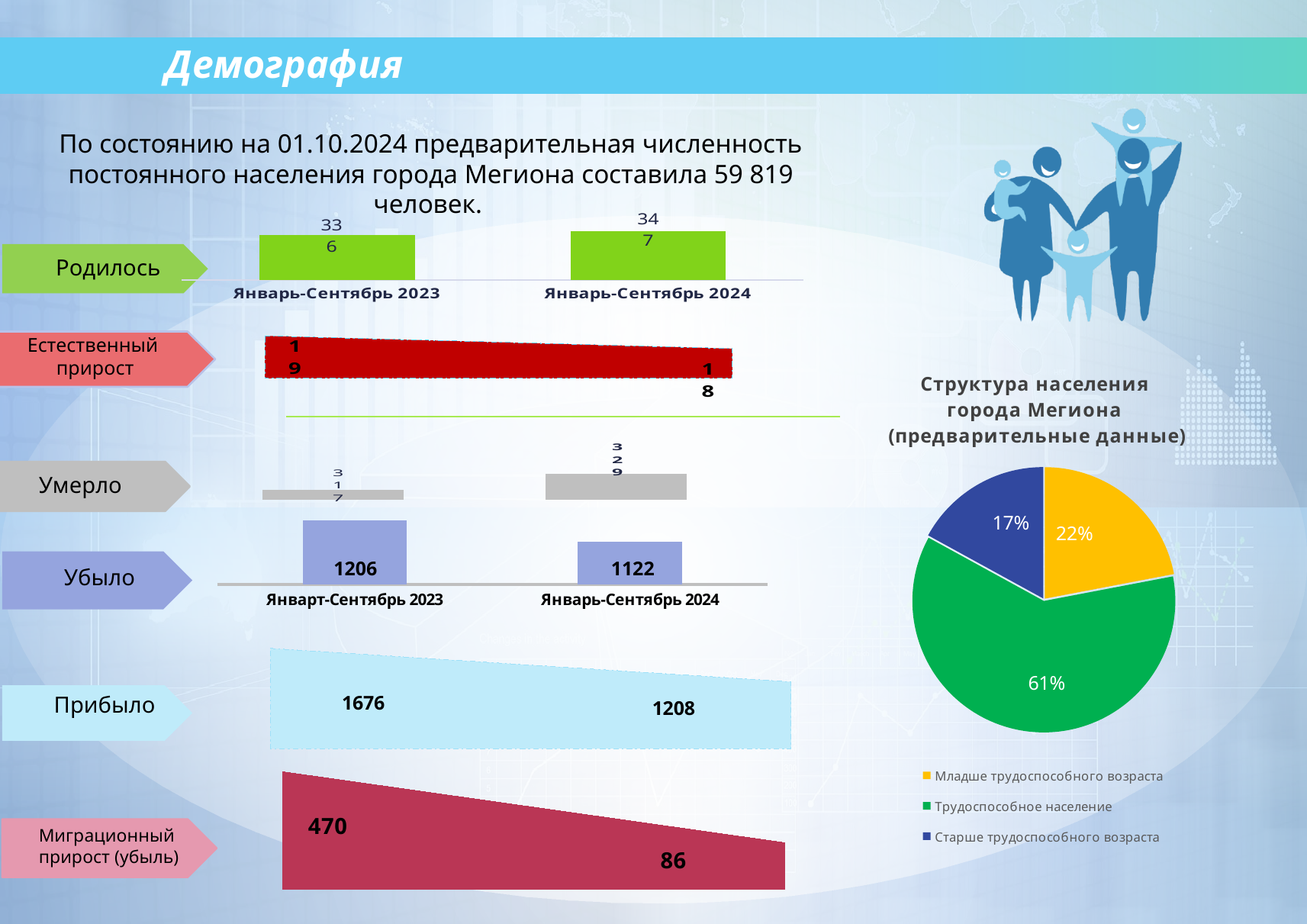
In the 'Убыло' bar chart, what is the value for Январт-Сентябрь 2023? 1206 In the 'Прибыло' chart, what is the first value shown (Январь-Сентябрь 2023)? 1676 In the 'Миграционный прирост (убыль)' chart, what is the value for 2024? 86 How many slices does the pie chart 'Структура населения города Мегиона' have? 3 In the pie chart 'Структура населения города Мегиона', what share is Трудоспособное население? 61% In the 'Убыло' bar chart, what is the difference between the 2023 and 2024 values? 84 In the 'Миграционный прирост (убыль)' chart, what is the difference between the 2023 value and the 2024 value? 384 In the 'Миграционный прирост (убыль)' chart, do the values rise or fall from 2023 to 2024? fall In the pie chart 'Структура населения города Мегиона', which category has the smallest share? Старше трудоспособного возраста In the 'Прибыло' chart, what is the second value shown (Январь-Сентябрь 2024)? 1208 In the pie chart 'Структура населения города Мегиона', what colour is the slice for Младше трудоспособного возраста? Yellow In the 'Убыло' bar chart, what is the value for Январь-Сентябрь 2024? 1122